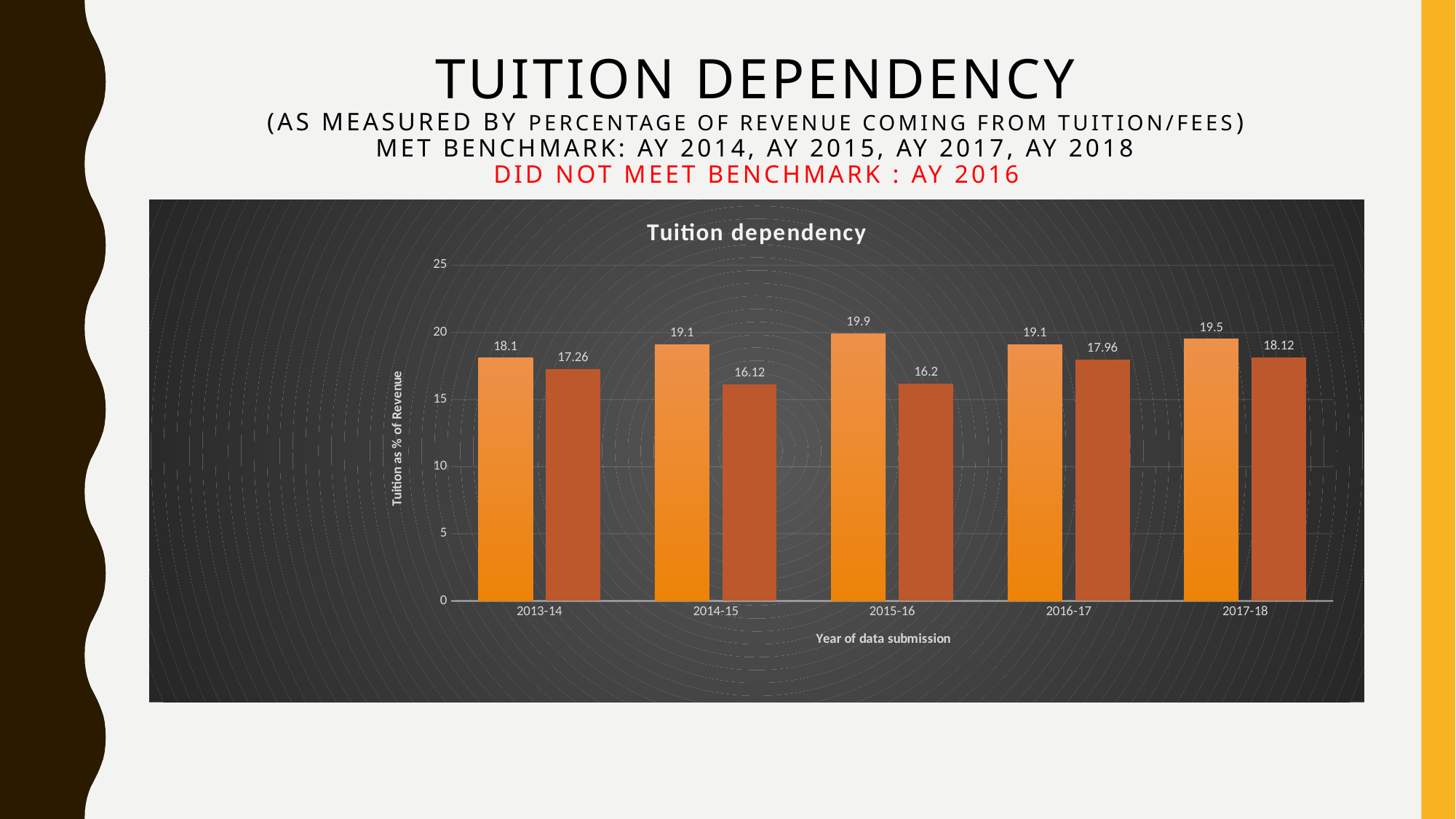
Is the value of the darker orange bar for 2014-15 greater or less than 20? less Which year has the highest value among the lighter orange (first) bars? 2015-16 What is the value of the darker orange (second) bar for 2014-15? 16.12 What is the value of the lighter orange (first) bar for 2015-16? 19.9 Which is larger: the darker orange bar for 2016-17 or the darker orange bar for 2013-14? 2016-17 Which year has the lowest value among the darker orange (second) bars? 2014-15 What is the label of the y axis? Tuition as % of Revenue How many year categories are shown on the x axis? 5 What is the chart title? Tuition dependency What is the difference between the two bars for 2015-16? 3.7 What is the value of the darker orange (second) bar for 2017-18? 18.12 What type of chart is shown on the slide? bar chart